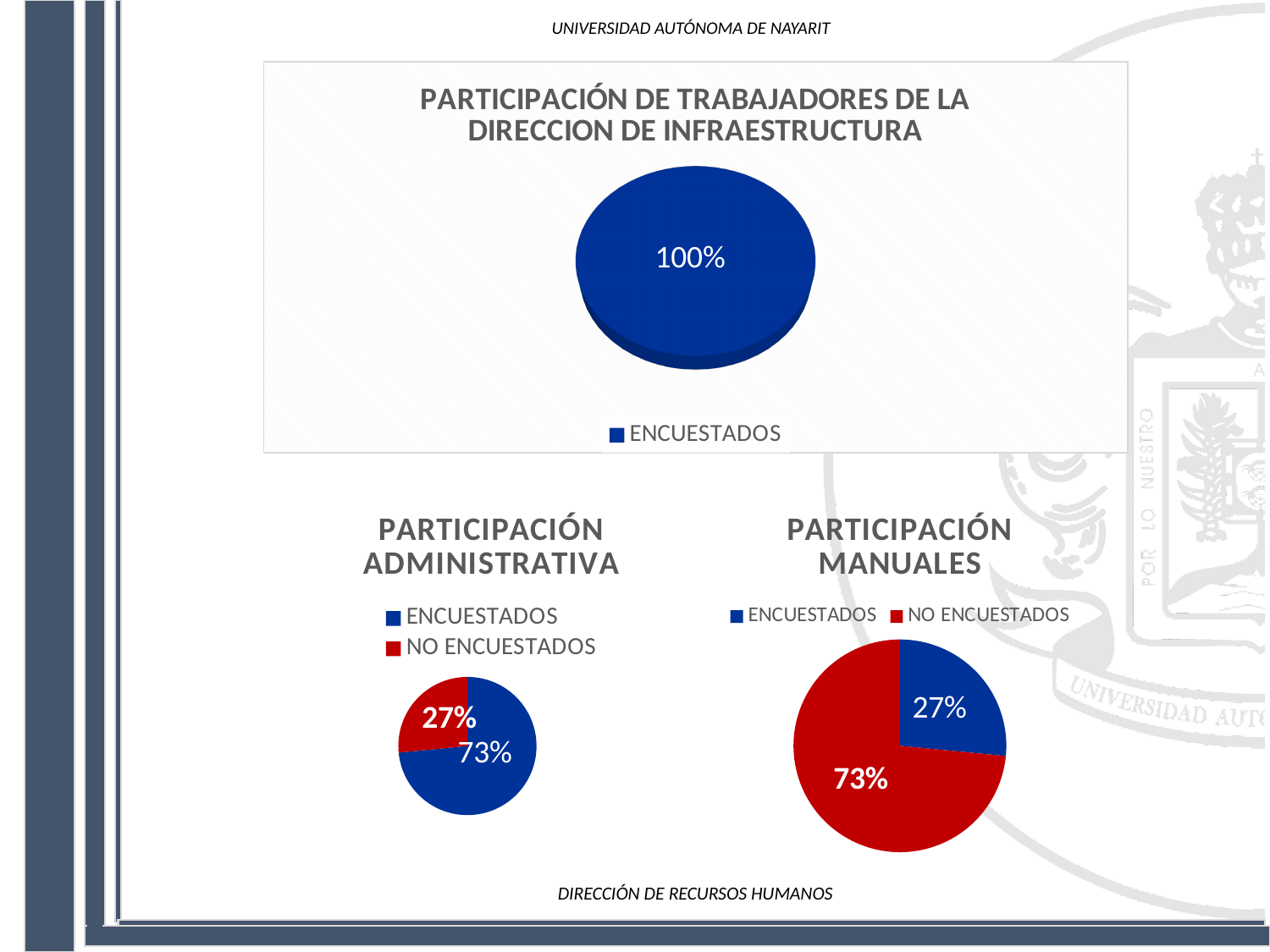
In the 'PARTICIPACIÓN ADMINISTRATIVA' chart, what share is ENCUESTADOS? 73% In the 'PARTICIPACIÓN DE TRABAJADORES DE LA DIRECCION DE INFRAESTRUCTURA' chart, what share is labelled for ENCUESTADOS? 100% In the 'PARTICIPACIÓN MANUALES' chart, which is larger, ENCUESTADOS or NO ENCUESTADOS? NO ENCUESTADOS How many slices does the 'PARTICIPACIÓN MANUALES' pie chart have? 2 What kind of chart is the 'PARTICIPACIÓN DE TRABAJADORES DE LA DIRECCION DE INFRAESTRUCTURA' chart? Pie chart In the 'PARTICIPACIÓN ADMINISTRATIVA' chart, what is the difference between the ENCUESTADOS and NO ENCUESTADOS shares? 46% In the 'PARTICIPACIÓN MANUALES' chart, which slice is the smallest? ENCUESTADOS In the 'PARTICIPACIÓN ADMINISTRATIVA' chart, what share is NO ENCUESTADOS? 27% In the 'PARTICIPACIÓN ADMINISTRATIVA' chart, which slice is the largest? ENCUESTADOS How many series does the legend of the 'PARTICIPACIÓN DE TRABAJADORES DE LA DIRECCION DE INFRAESTRUCTURA' chart list? 1